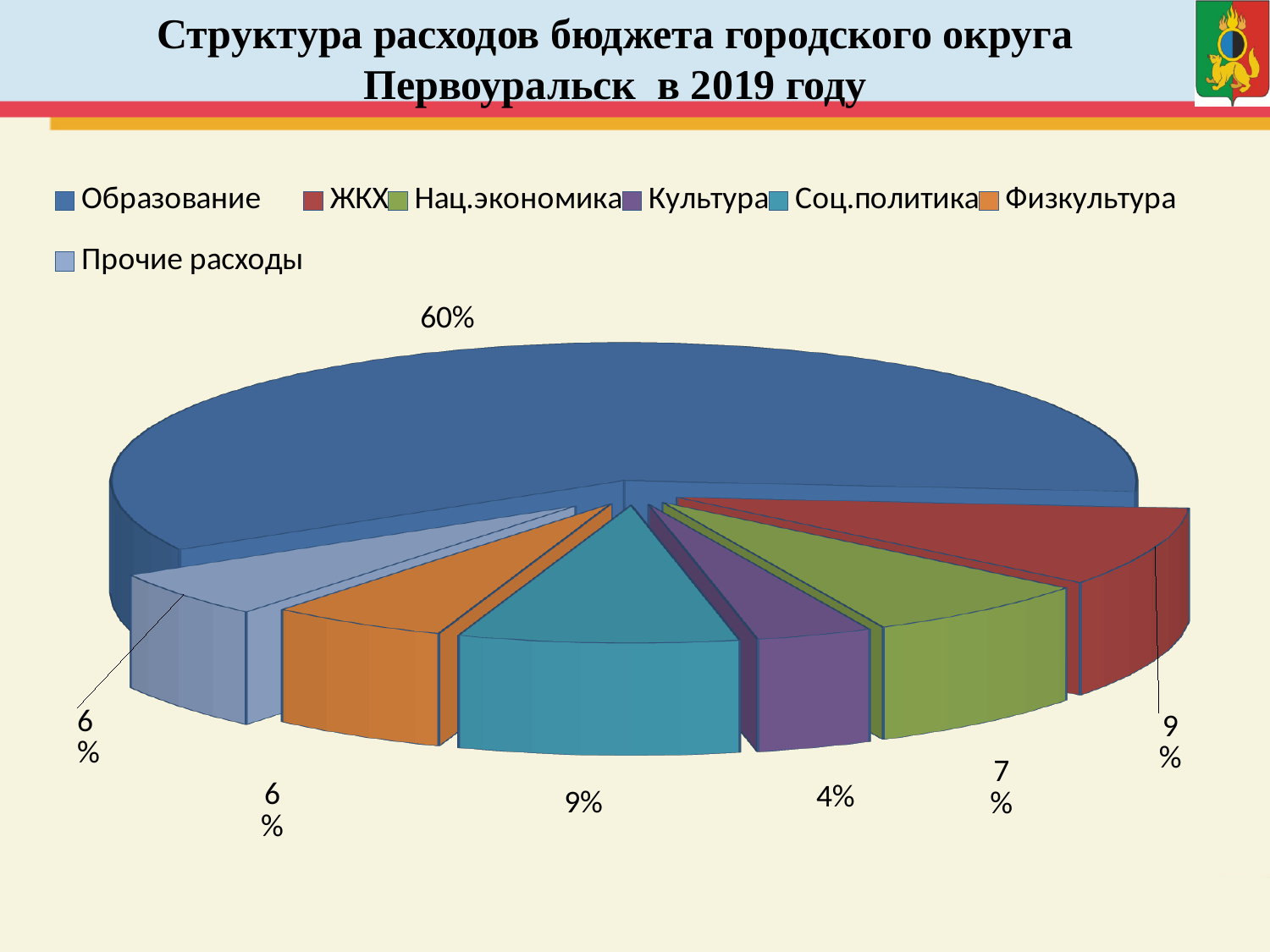
What is the title of the slide containing the chart? Структура расходов бюджета городского округа Первоуральск в 2019 году What percentage is shown for Нац.экономика? 7% What percentage is shown for Соц.политика? 9% What is the difference in percentage points between Образование and ЖКХ? 51 Which category has the smallest share of the pie? Культура What percentage is shown for Культура? 4% What percentage is shown for ЖКХ? 9% What kind of chart is shown on the slide? Pie chart Which is larger, the share for Нац.экономика or the share for Культура? Нац.экономика How many categories does the pie chart have? 7 Which category has the largest share of the pie? Образование What share of the budget expenditure goes to Образование? 60%